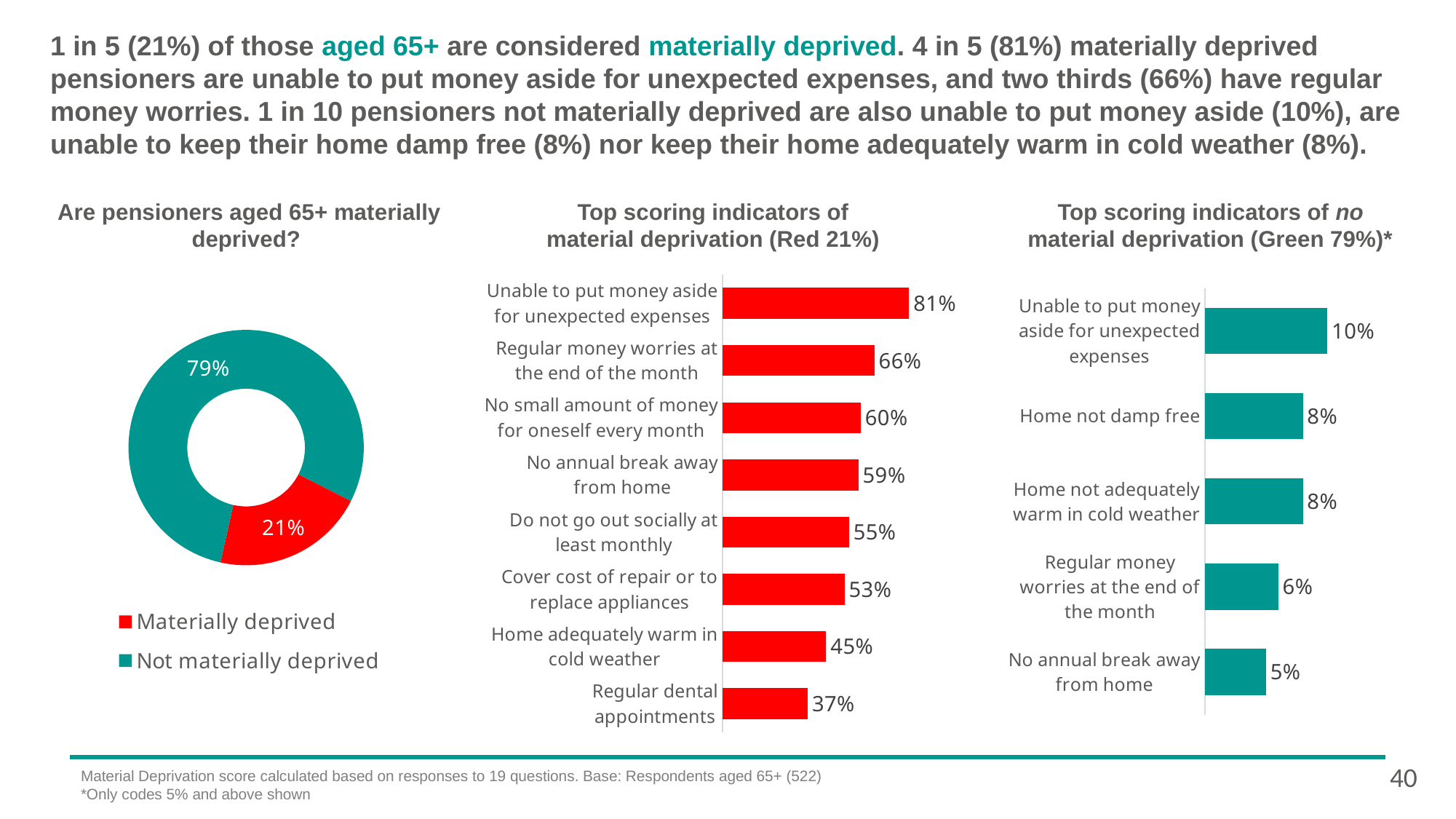
In the 'Top scoring indicators of material deprivation' chart, which is larger: 'Do not go out socially at least monthly' or 'Home adequately warm in cold weather'? Do not go out socially at least monthly In the 'Top scoring indicators of material deprivation' chart, which indicator has the highest value? Unable to put money aside for unexpected expenses How many indicators are shown in the 'Top scoring indicators of material deprivation' chart? 8 In the 'Top scoring indicators of material deprivation' chart, what is the value for 'No annual break away from home'? 59% In the 'Are pensioners aged 65+ materially deprived?' chart, what share of pensioners are materially deprived? 21% In the 'Top scoring indicators of no material deprivation' chart, what is the value for 'Regular money worries at the end of the month'? 6% In the 'Top scoring indicators of no material deprivation' chart, which indicator has the highest value? Unable to put money aside for unexpected expenses In the 'Top scoring indicators of material deprivation' chart, what is the difference between 'Unable to put money aside for unexpected expenses' and 'Regular money worries at the end of the month'? 15 percentage points How many indicators are shown in the 'Top scoring indicators of no material deprivation' chart? 5 In the 'Top scoring indicators of material deprivation' chart, which indicator has the lowest value? Regular dental appointments In the 'Are pensioners aged 65+ materially deprived?' chart, what share are not materially deprived? 79% What kind of chart is the 'Are pensioners aged 65+ materially deprived?' chart? Doughnut (pie) chart